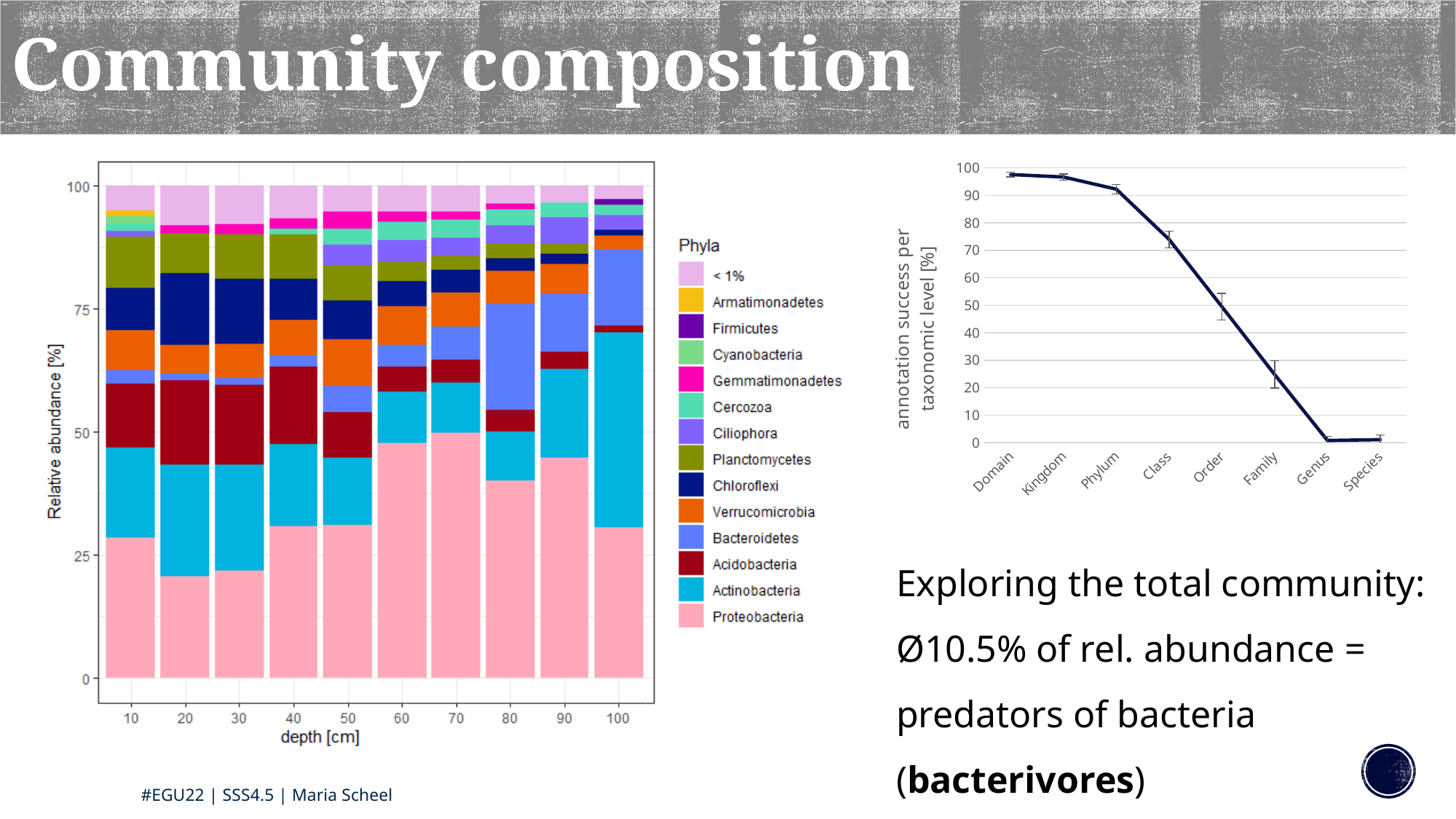
In the right chart, how many taxonomic levels are shown on the x axis? 8 In the left chart, what is the title of the legend? Phyla In the right chart, is the annotation success for Genus greater or less than 10%? less In the left chart, how many depth categories are shown on the x axis? 10 In the right chart, does annotation success rise or fall from Domain to Species? fall In the left chart, how many entries does the Phyla legend list? 14 In the left chart, is the relative abundance of Proteobacteria at 20 cm depth greater or less than 25%? less What kind of chart is the chart on the left showing relative abundance by depth? stacked bar chart In the left chart, is the relative abundance of Proteobacteria larger at 70 cm or at 20 cm depth? 70 cm What kind of chart is the chart on the right showing annotation success per taxonomic level? line chart In the right chart, which taxonomic level has the highest annotation success? Domain In the left chart, is the relative abundance of Proteobacteria at 10 cm depth greater or less than 25%? greater